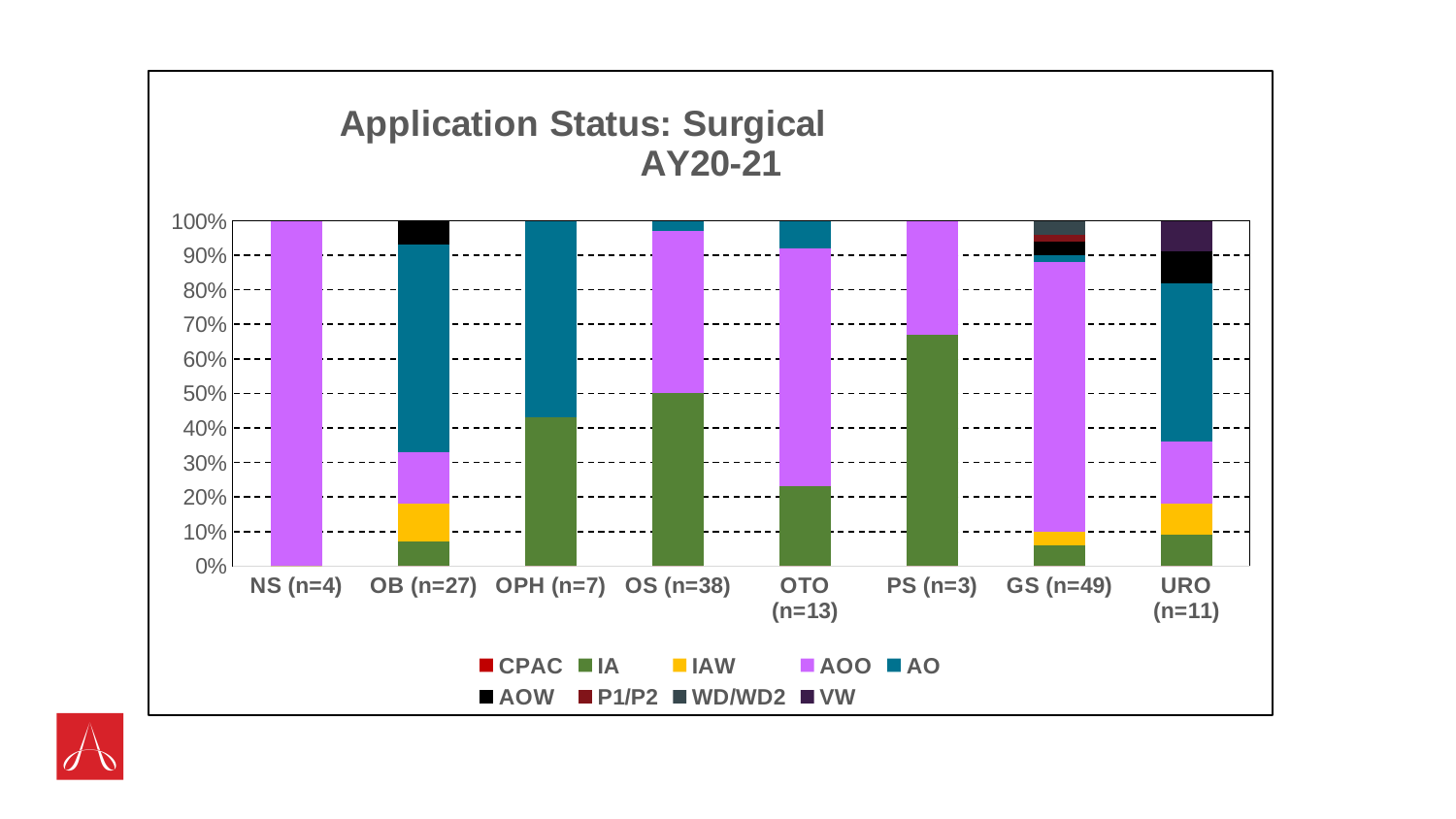
What percentage of the OS (n=38) bar is made up by IA? 50% What type of chart is shown on the slide? Stacked bar chart What is the title of the chart? Application Status: Surgical AY20-21 What percentage of the NS (n=4) bar is made up by AOO? 100% Is the IA share for OTO (n=13) greater or less than 30%? less How many series does the legend list? 9 Which colour represents the AOO series in the legend? Purple Is the IA share for PS (n=3) greater or less than 60%? greater Which category has the largest sample size (n) in its label? GS (n=49) Which category has a larger IA share, PS (n=3) or OTO (n=13)? PS (n=3) Is the IA share for GS (n=49) greater or less than 10%? less How many categories are shown on the x axis? 8